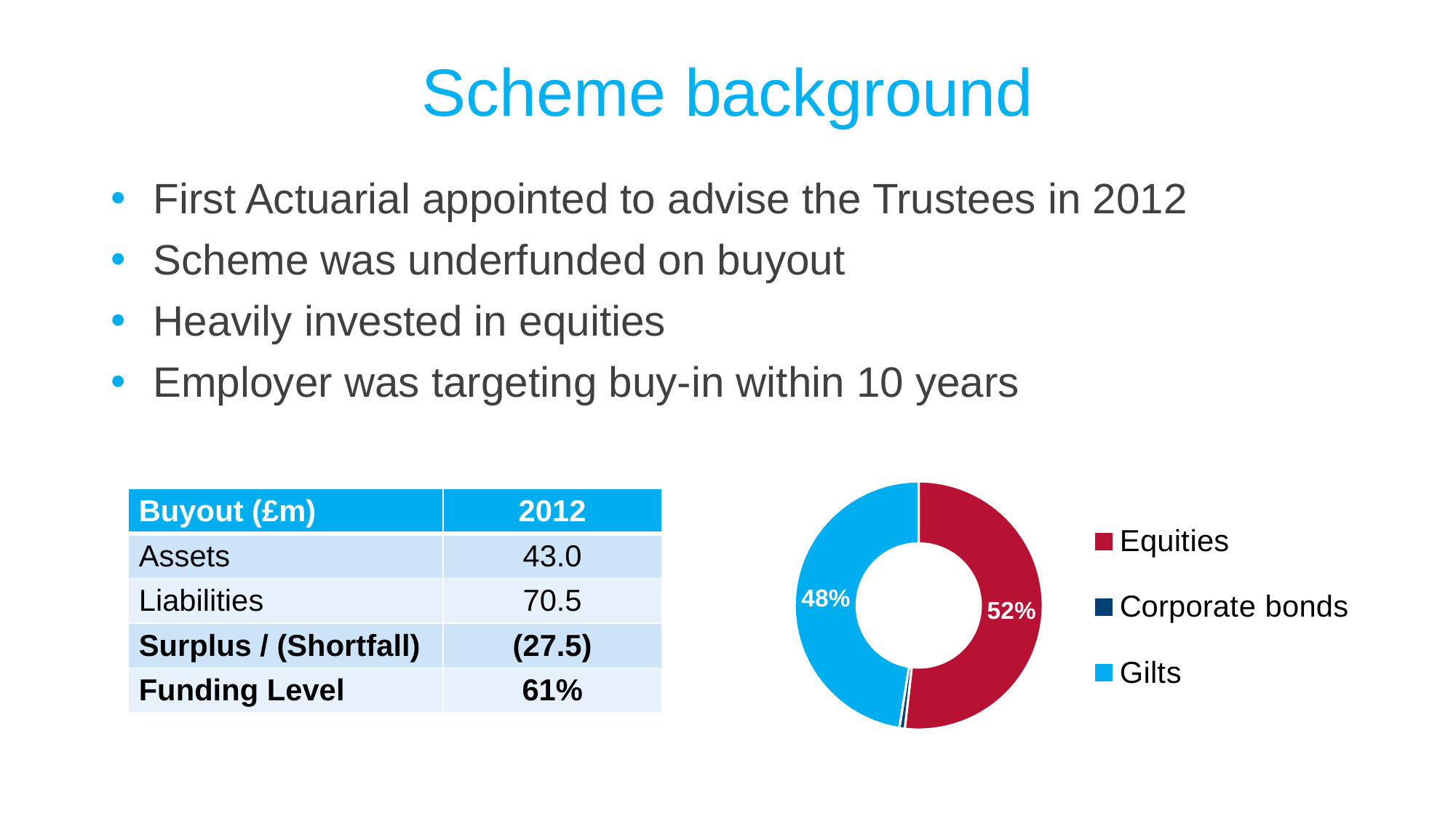
Which category has the smallest slice in the doughnut chart? Corporate bonds Which slice is larger in the doughnut chart, Equities or Gilts? Equities By how many percentage points does the Equities share exceed the Gilts share in the doughnut chart? 4 What colour represents Equities in the doughnut chart? Red What share of the doughnut chart is labelled for Equities? 52% Which legend entry of the doughnut chart has no percentage label shown on its slice? Corporate bonds What share of the doughnut chart is labelled for Gilts? 48% What kind of chart is shown on the right of the slide? Doughnut (pie) chart How many categories does the legend of the doughnut chart list? 3 Which category has the largest slice in the doughnut chart? Equities